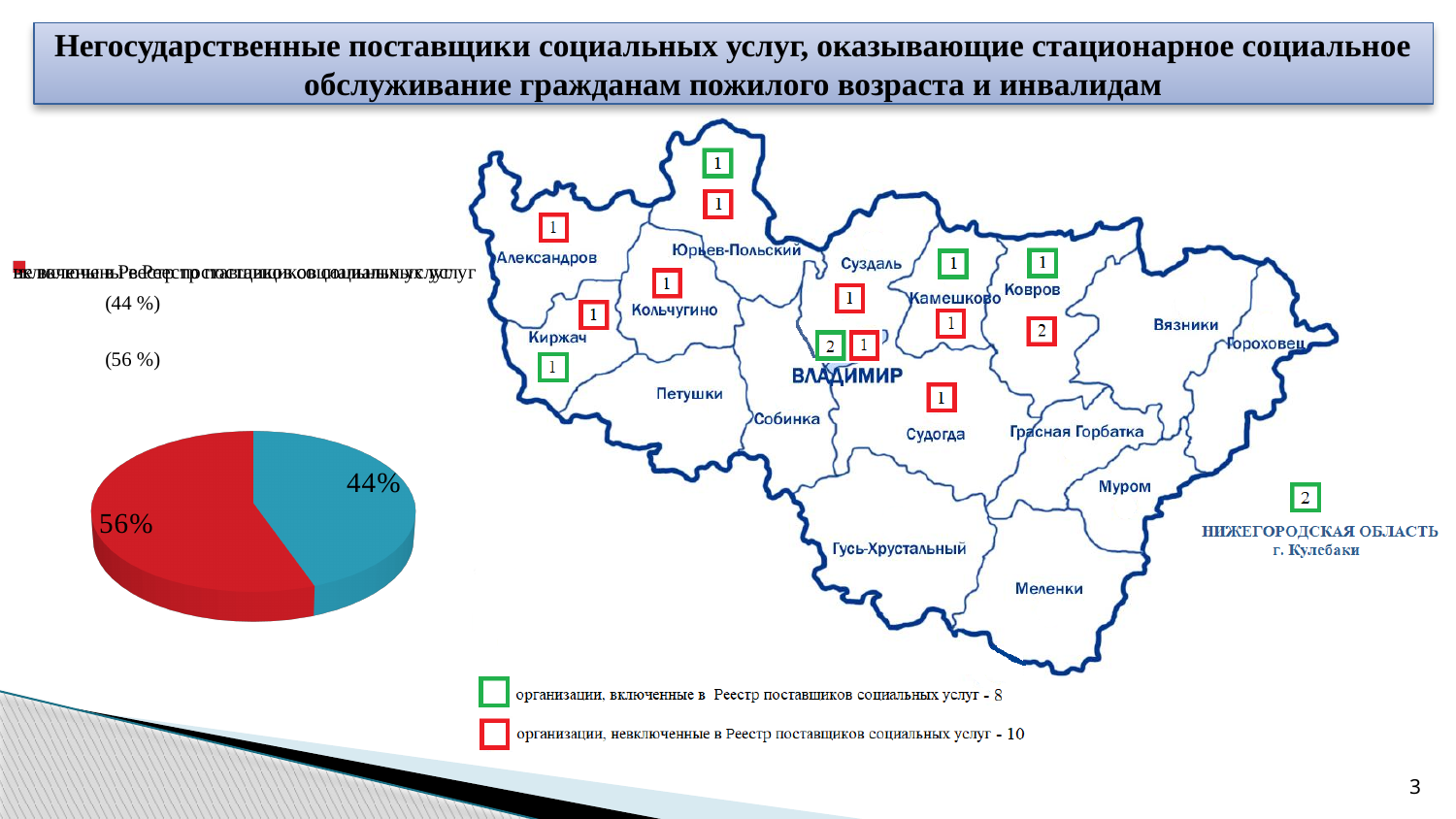
What kind of chart is shown on the left of the slide? pie chart By how many percentage points does the red slice exceed the blue slice in the pie chart? 12 Which slice of the pie chart is the largest? the red slice (56%) What percentage is shown on the blue slice of the pie chart? 44% What percentage is shown on the red slice of the pie chart? 56% What two colours are used for the slices of the pie chart? red and blue How many slices does the pie chart have? 2 Is the red slice of the pie chart greater or less than 50%? greater Which slice of the pie chart is the smallest? the blue slice (44%) Which slice of the pie chart is larger, the red one or the blue one? the red one